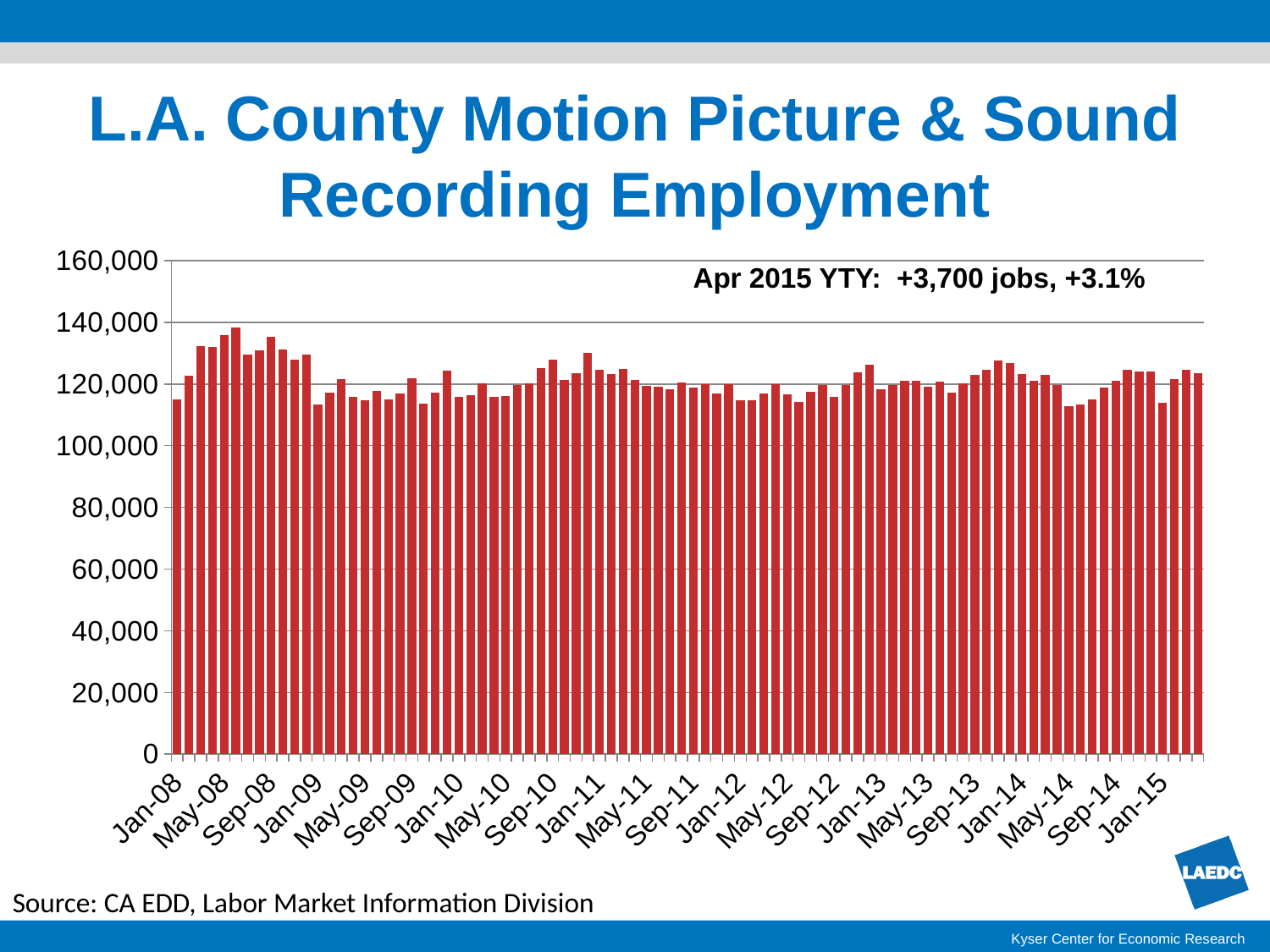
Is the value for Jan-15 greater or less than 100,000? greater Is the value for Jan-08 greater or less than 120,000? less What is the title of the chart? L.A. County Motion Picture & Sound Recording Employment Is the value for Jan-08 greater or less than 100,000? greater In which year does the highest bar on the chart occur? 2008 What kind of chart is shown on the slide? Bar chart According to the annotation on the chart, what was the Apr 2015 year-to-year percentage change? +3.1% What is the highest value shown on the vertical axis? 160,000 According to the annotation on the chart, how many jobs were added year-to-year in Apr 2015? +3,700 jobs What is the first month label on the horizontal axis? Jan-08 How many data series are plotted on the chart? 1